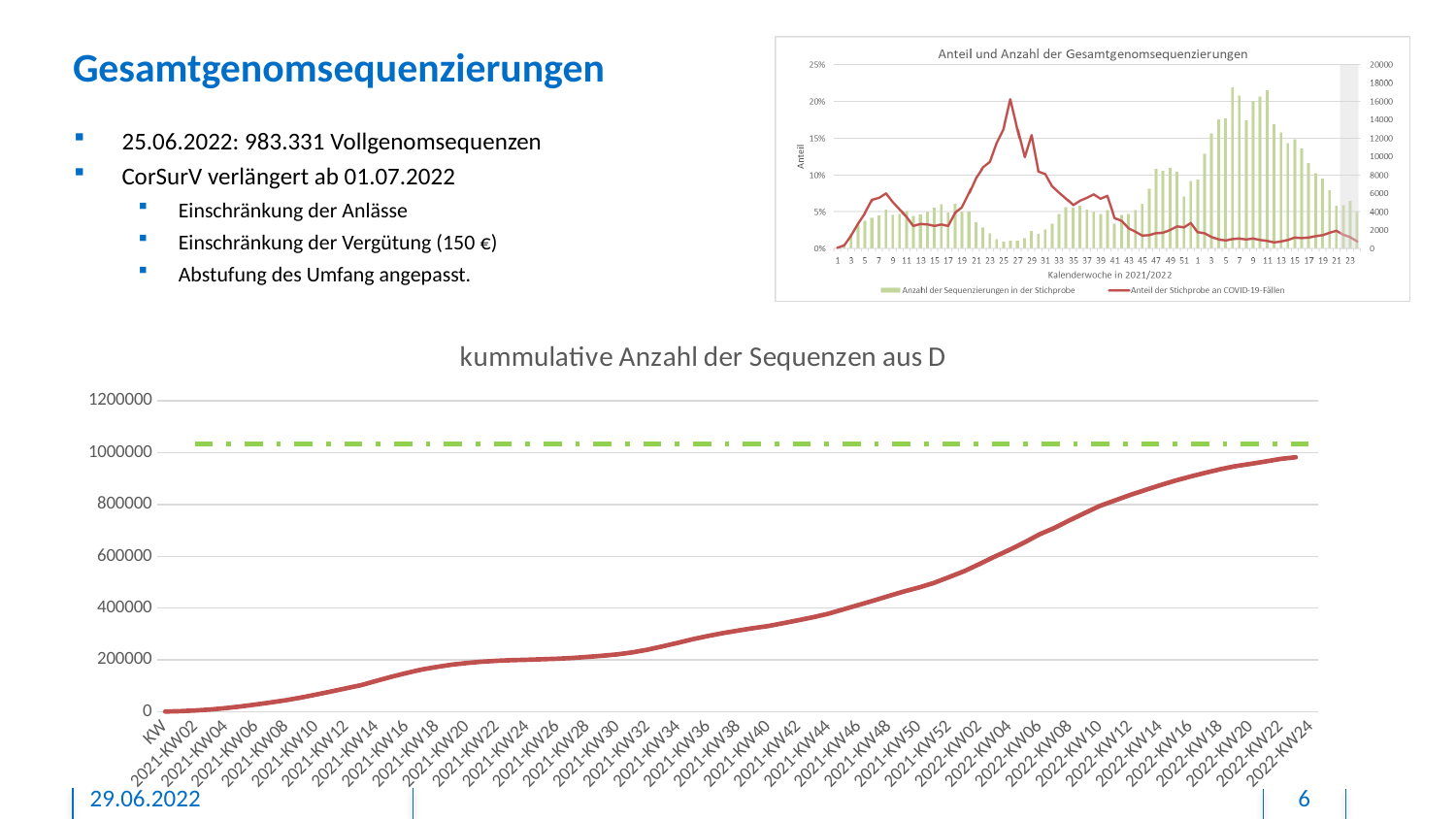
What is the x-axis label of the top-right chart 'Anteil und Anzahl der Gesamtgenomsequenzierungen'? Kalenderwoche in 2021/2022 What is the title of the bottom chart? kummulative Anzahl der Sequenzen aus D What is the title of the chart in the top right of the slide? Anteil und Anzahl der Gesamtgenomsequenzierungen What kind of chart is the bottom chart titled 'kummulative Anzahl der Sequenzen aus D'? line chart In the bottom chart 'kummulative Anzahl der Sequenzen aus D', is the value for 2021-KW20 greater or less than 400000? less In the bottom chart 'kummulative Anzahl der Sequenzen aus D', do the values rise or fall along the x axis? rise In the bottom chart 'kummulative Anzahl der Sequenzen aus D', is the value for 2021-KW50 greater or less than 400000? greater In the top-right chart 'Anteil und Anzahl der Gesamtgenomsequenzierungen', is the peak of the red line 'Anteil der Stichprobe an COVID-19-Fällen' greater or less than 15%? greater How many series does the legend of the top-right chart 'Anteil und Anzahl der Gesamtgenomsequenzierungen' list? 2